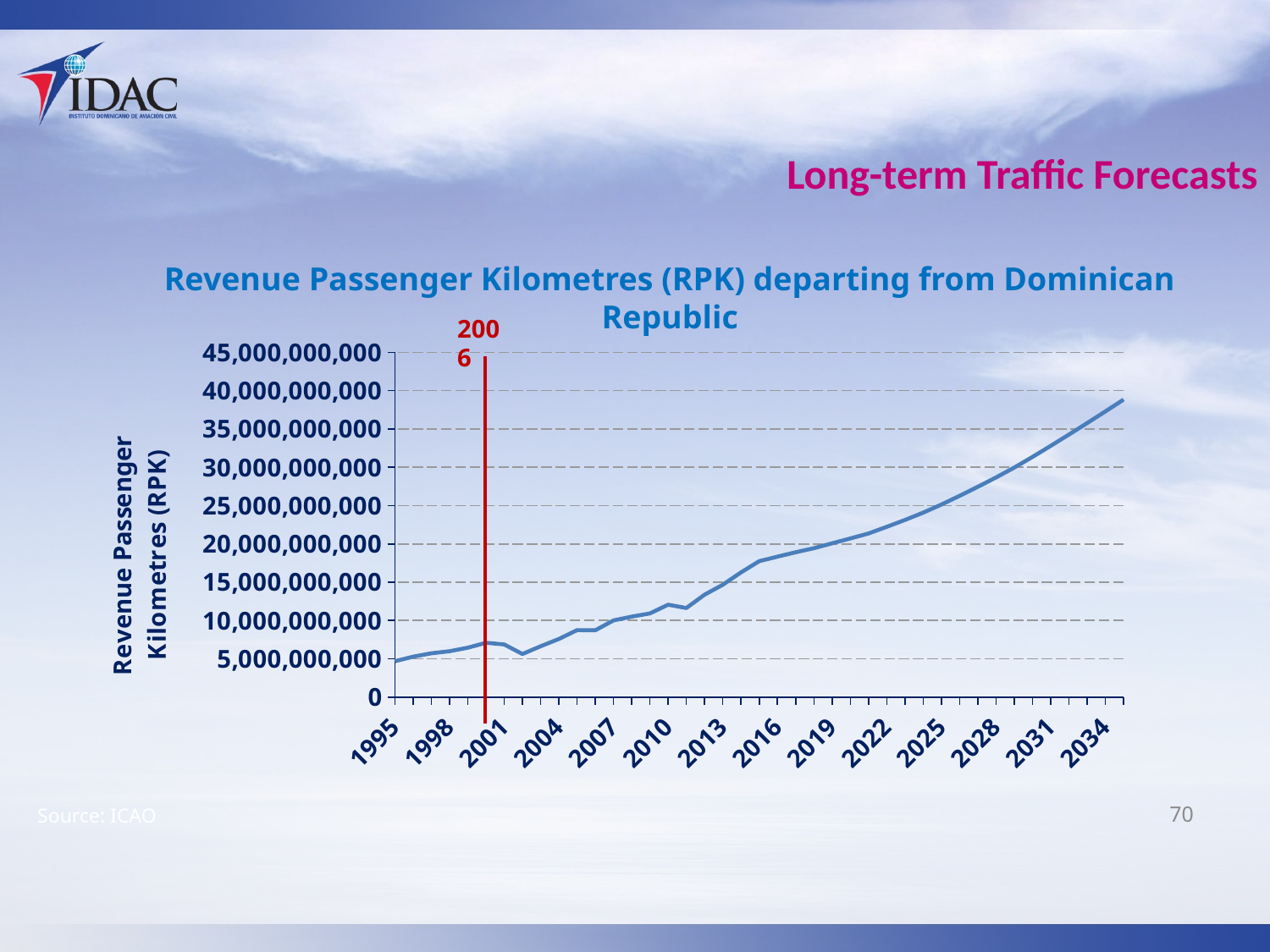
How many year labels are shown on the x axis? 14 Is the RPK value for 2016 greater or less than 15,000,000,000? greater Is the RPK value for 2004 greater or less than 10,000,000,000? less What year is marked by the red vertical line on the chart? 2006 What is the highest value shown on the y axis? 45,000,000,000 Is the RPK value for 2025 greater or less than 20,000,000,000? greater Which year has the larger RPK value, 1995 or 2034? 2034 What kind of chart is shown on the slide? line chart Overall, do the RPK values rise or fall from 1995 to 2034? rise What is the title of the chart? Revenue Passenger Kilometres (RPK) departing from Dominican Republic Which year shown on the x axis has the highest RPK value? 2034